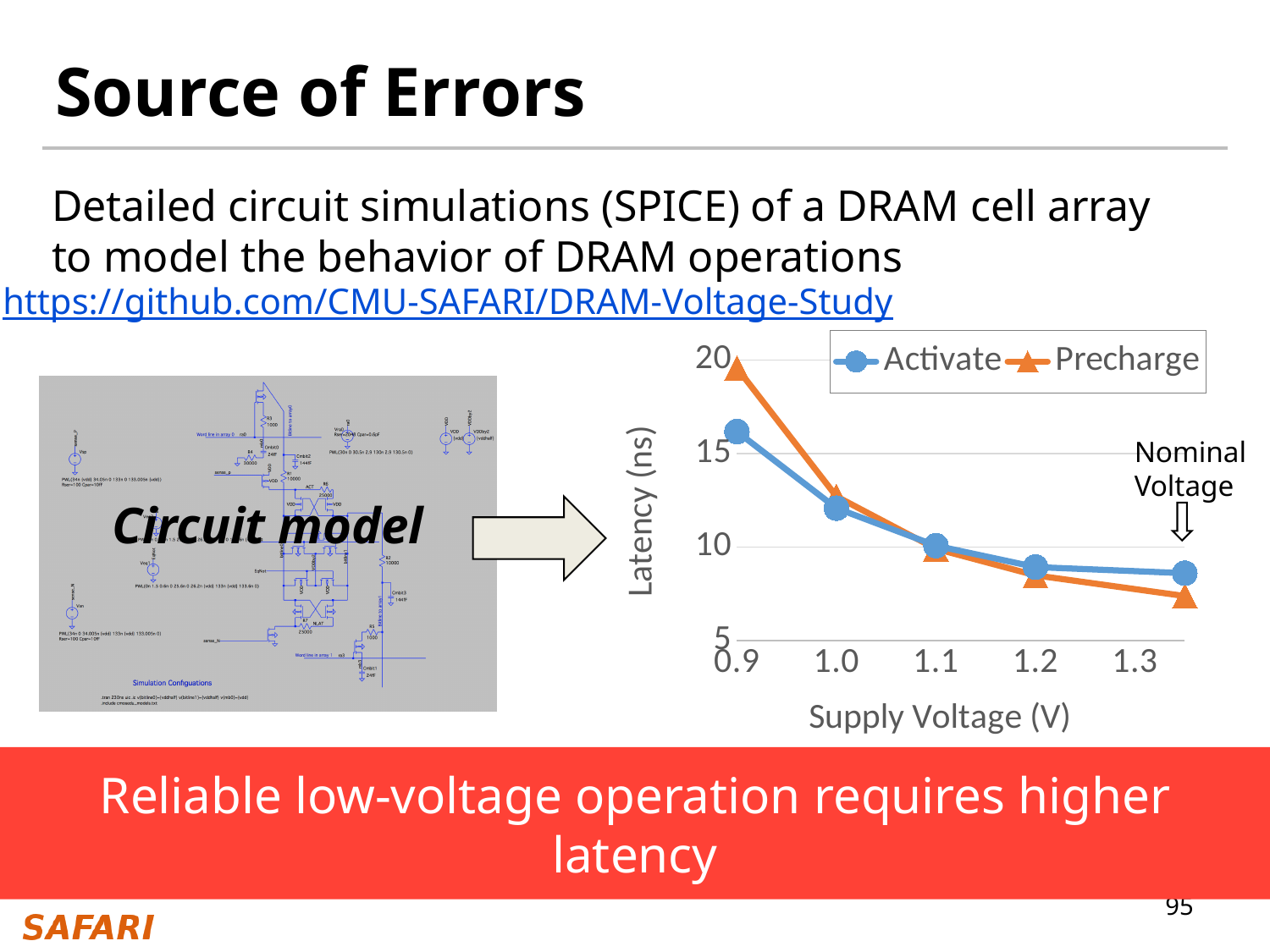
How many data points are plotted for the Activate series? 5 Does latency rise or fall as supply voltage increases along the x axis? fall Is the Activate latency at 1.0 V greater or less than 10 ns? greater What kind of chart is shown on the slide? line chart Is the Precharge latency at 0.9 V greater or less than 15 ns? greater What are the two series named in the chart's legend? Activate and Precharge How many series does the chart's legend list? 2 At 0.9 V, which series has the higher latency, Activate or Precharge? Precharge What is the label of the chart's y axis? Latency (ns) Is the Activate latency at 0.9 V greater or less than 15 ns? greater At the rightmost (nominal voltage) point, which series has the higher latency, Activate or Precharge? Activate